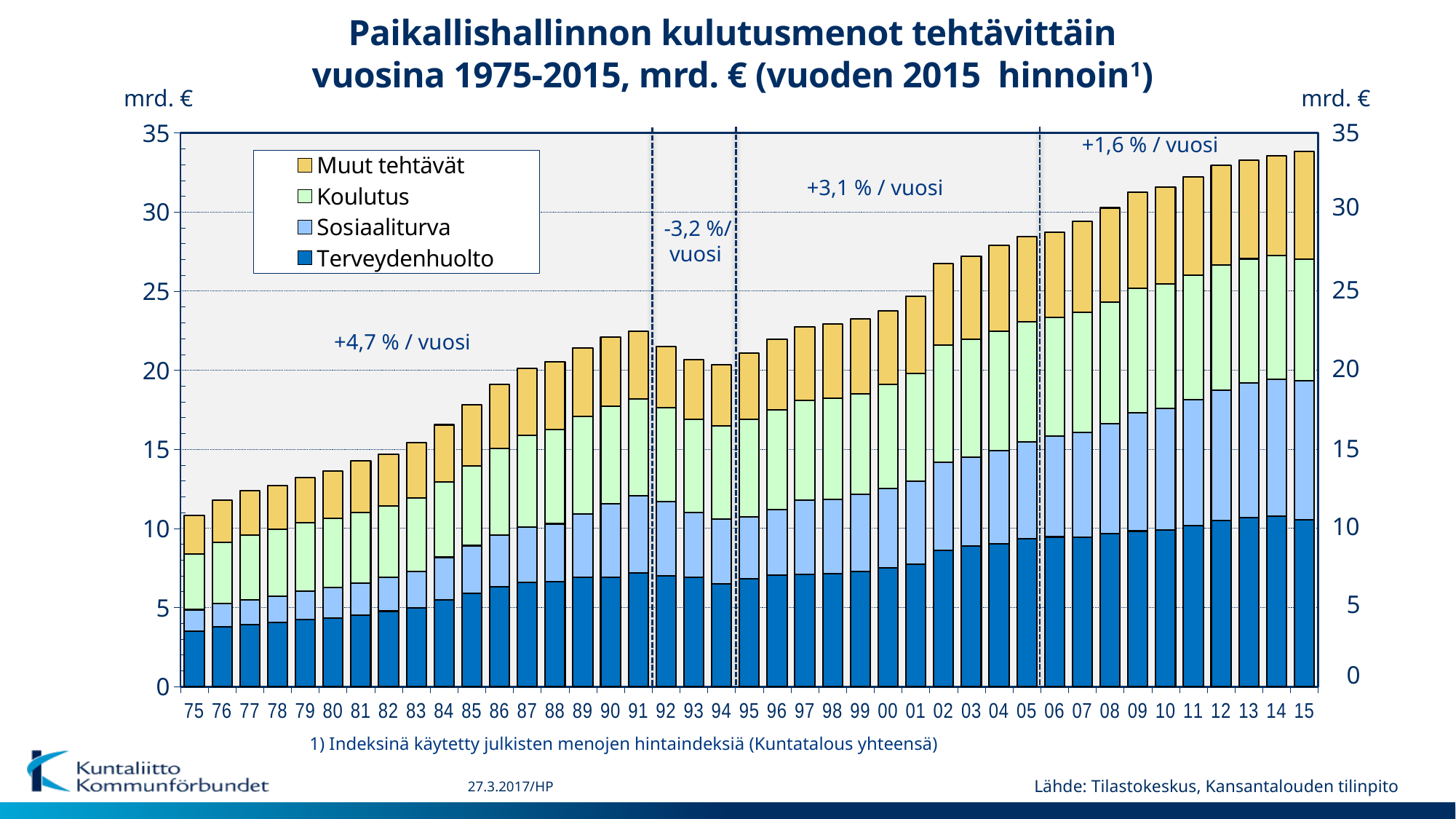
Which year has the highest total bar? 15 What kind of chart is shown on the slide? stacked bar chart Is the Terveydenhuolto value for 75 greater or less than 5? less Is the total value for 15 greater or less than 30? greater Do the total values generally rise or fall from 75 to 15? rise Is the total value for 00 greater or less than 20? greater Which year has the lowest total bar? 75 How many series does the legend list? 4 What annual growth rate is annotated for the period from 06 to 15? +1,6 % / vuosi How many years (bars) are plotted on the x axis? 41 Which year has the larger total bar, 91 or 94? 91